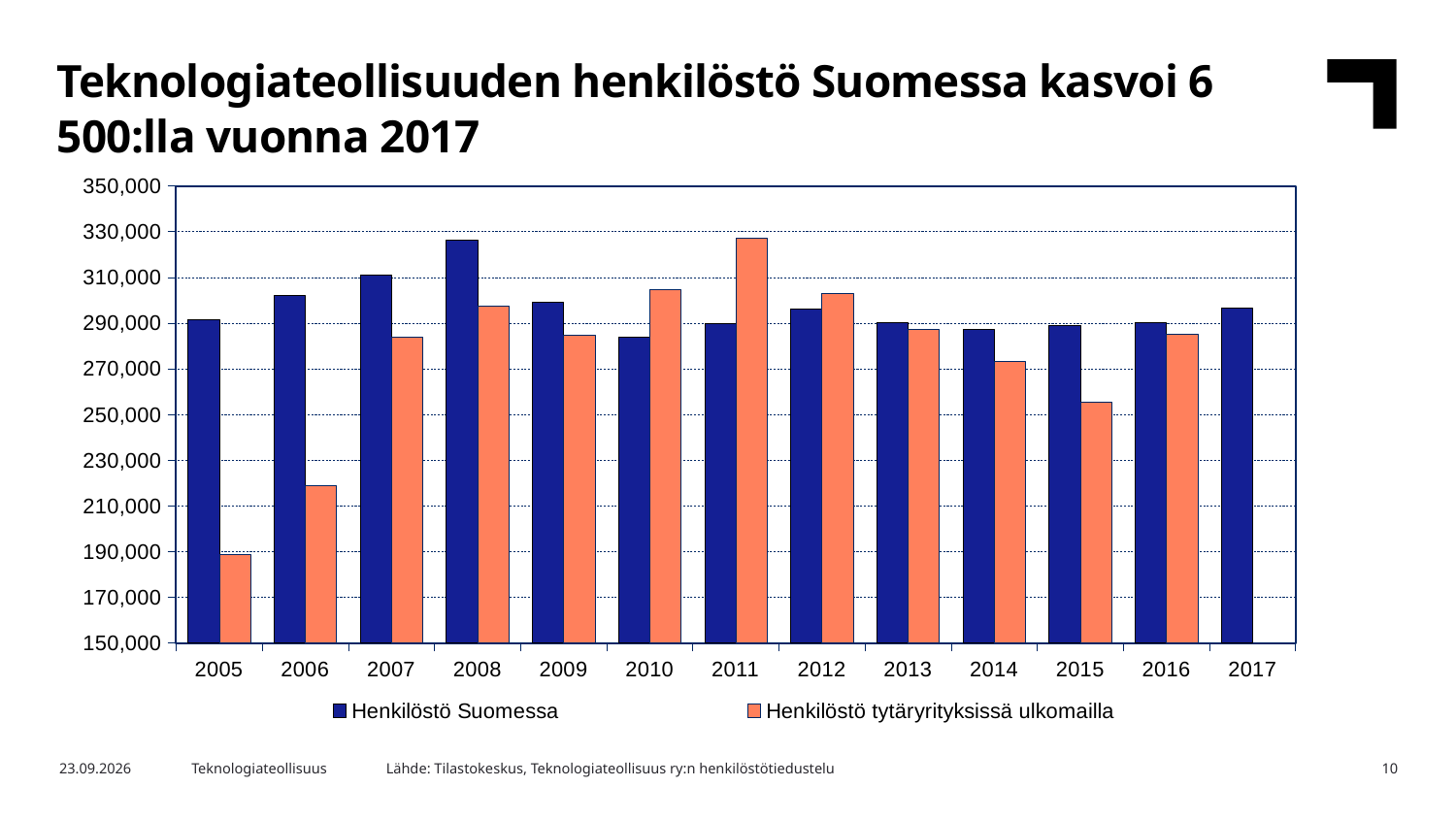
In which year is the value for Henkilöstö tytäryrityksissä ulkomailla lowest? 2005 Is the value for Henkilöstö tytäryrityksissä ulkomailla in 2005 greater or less than 210,000? less How many series does the legend list? 2 How many years are shown on the x axis? 13 Is the value for Henkilöstö Suomessa in 2008 greater or less than 310,000? greater In 2011, which series has the larger value, Henkilöstö Suomessa or Henkilöstö tytäryrityksissä ulkomailla? Henkilöstö tytäryrityksissä ulkomailla What kind of chart is shown on the slide? Bar chart Is the value for Henkilöstö tytäryrityksissä ulkomailla in 2011 greater or less than 310,000? greater In 2015, which series has the larger value, Henkilöstö Suomessa or Henkilöstö tytäryrityksissä ulkomailla? Henkilöstö Suomessa Does the value for Henkilöstö Suomessa rise or fall from 2005 to 2008? rise In which year is the value for Henkilöstö Suomessa highest? 2008 In which year is the value for Henkilöstö tytäryrityksissä ulkomailla highest? 2011